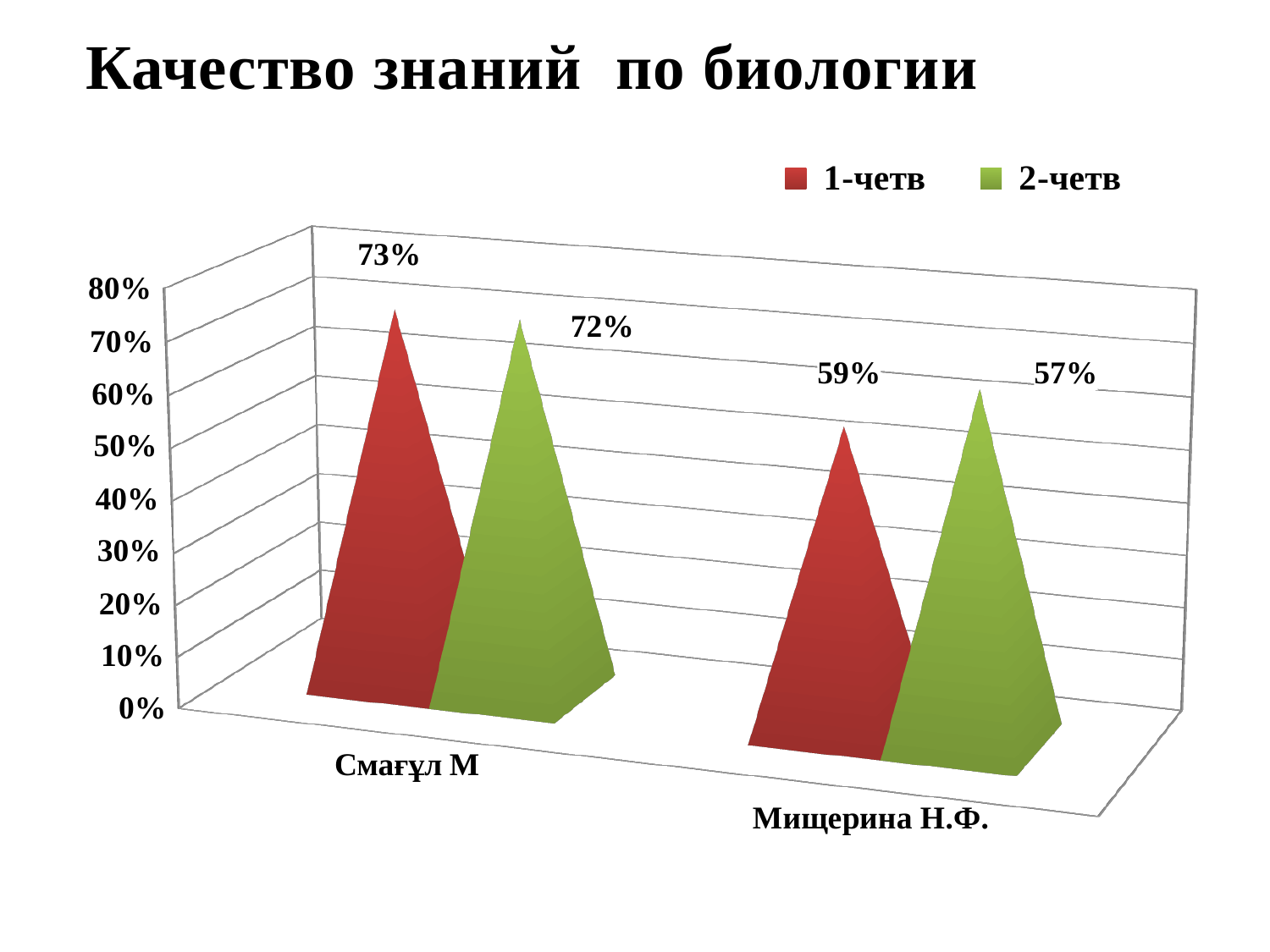
What is the difference between the 1-четв and 2-четв values for Мищерина Н.Ф.? 2% What is the value for Мищерина Н.Ф. in the 1-четв series? 59% What is the value for Смағұл М in the 2-четв series? 72% What is the value for Мищерина Н.Ф. in the 2-четв series? 57% What is the title of the chart? Качество знаний по биологии What is the value for Смағұл М in the 1-четв series? 73% How many categories are shown on the x axis? 2 Which category has the highest value in the 1-четв series? Смағұл М Which category has the lowest value in the 2-четв series? Мищерина Н.Ф. Which is larger: the 2-четв value for Смағұл М or the 2-четв value for Мищерина Н.Ф.? Смағұл М How many series does the legend list? 2 What is the difference between the 1-четв values for Смағұл М and Мищерина Н.Ф.? 14%